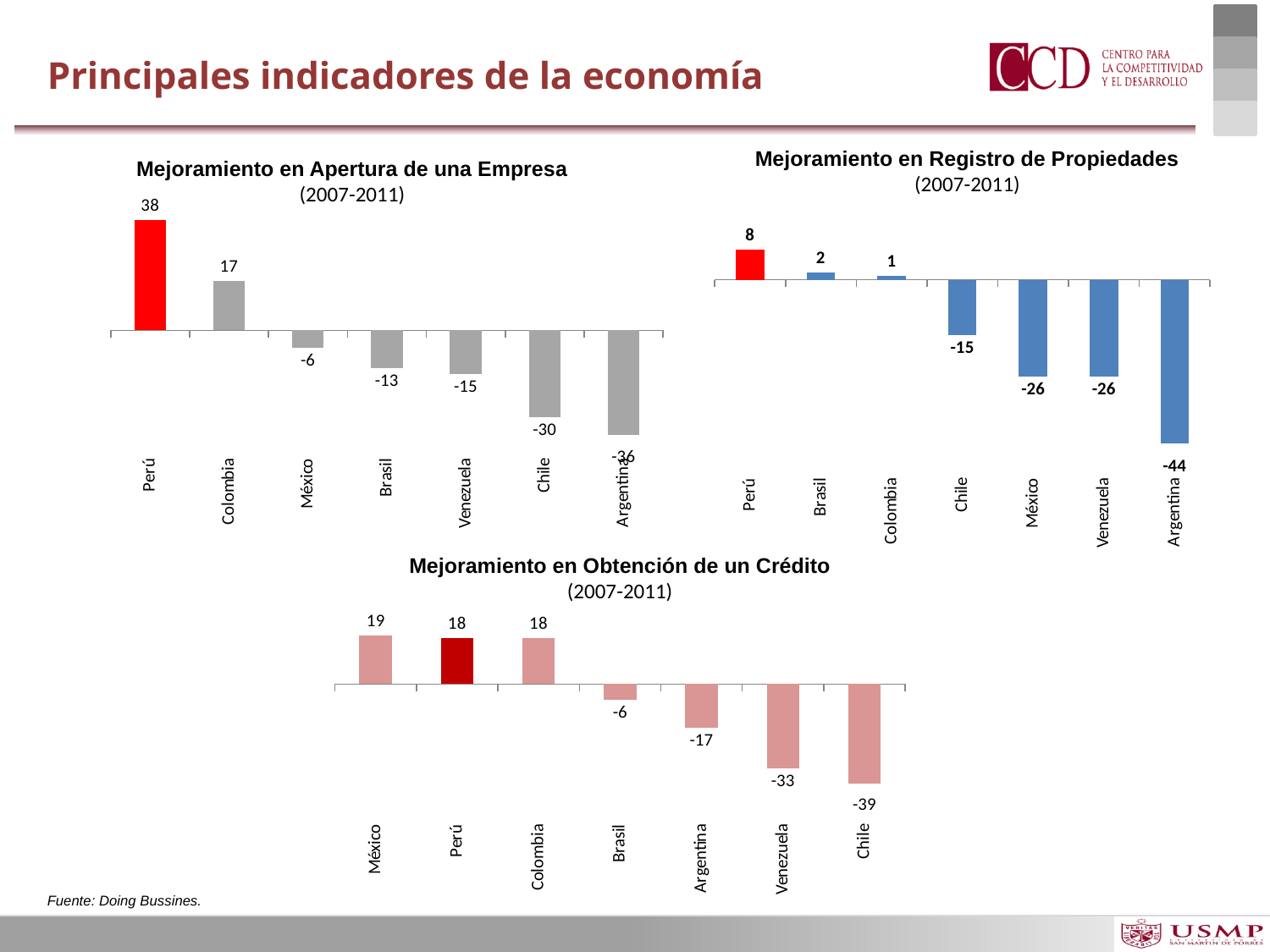
In the chart 'Mejoramiento en Registro de Propiedades', which is larger, the value for Brasil or the value for Chile? Brasil In the chart 'Mejoramiento en Apertura de una Empresa', what is the value for Perú? 38 In the chart 'Mejoramiento en Registro de Propiedades', what is the value for Chile? -15 In the chart 'Mejoramiento en Obtención de un Crédito', what is the difference between the values for Venezuela and Chile? 6 In the chart 'Mejoramiento en Registro de Propiedades', which country has the highest value? Perú In the chart 'Mejoramiento en Apertura de una Empresa', which country has the lowest value? Argentina In the chart 'Mejoramiento en Apertura de una Empresa', how many countries are shown? 7 In the chart 'Mejoramiento en Apertura de una Empresa', what is the difference between the values for Perú and Colombia? 21 In the chart 'Mejoramiento en Obtención de un Crédito', what is the value for México? 19 What type of chart is 'Mejoramiento en Obtención de un Crédito'? Bar chart In the chart 'Mejoramiento en Obtención de un Crédito', which country has the lowest value? Chile In the chart 'Mejoramiento en Registro de Propiedades', what is the value for Argentina? -44